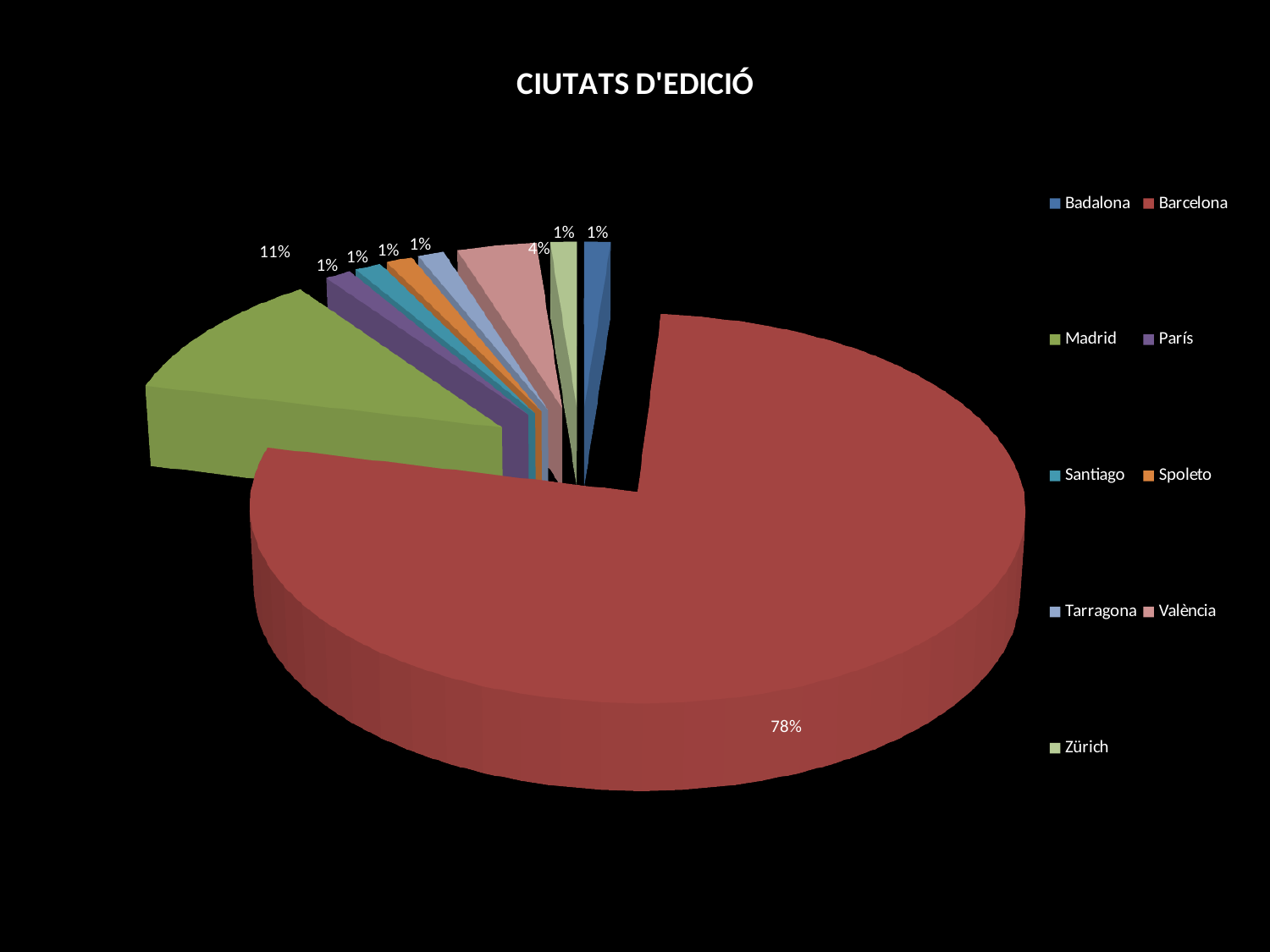
How many cities are listed in the chart's legend? 9 What is the difference in percentage points between Barcelona and Madrid? 67 What percentage is shown for Madrid? 11% What percentage is shown for Badalona? 1% What kind of chart is shown on the slide? pie chart Which colour is used for the Barcelona slice? red What is the title of the chart? CIUTATS D'EDICIÓ What percentage is shown for València? 4% What share of the pie does Barcelona have? 78% Which has a larger share, Madrid or València? Madrid Which city has the largest slice of the pie? Barcelona What is the difference in percentage points between Madrid and València? 7